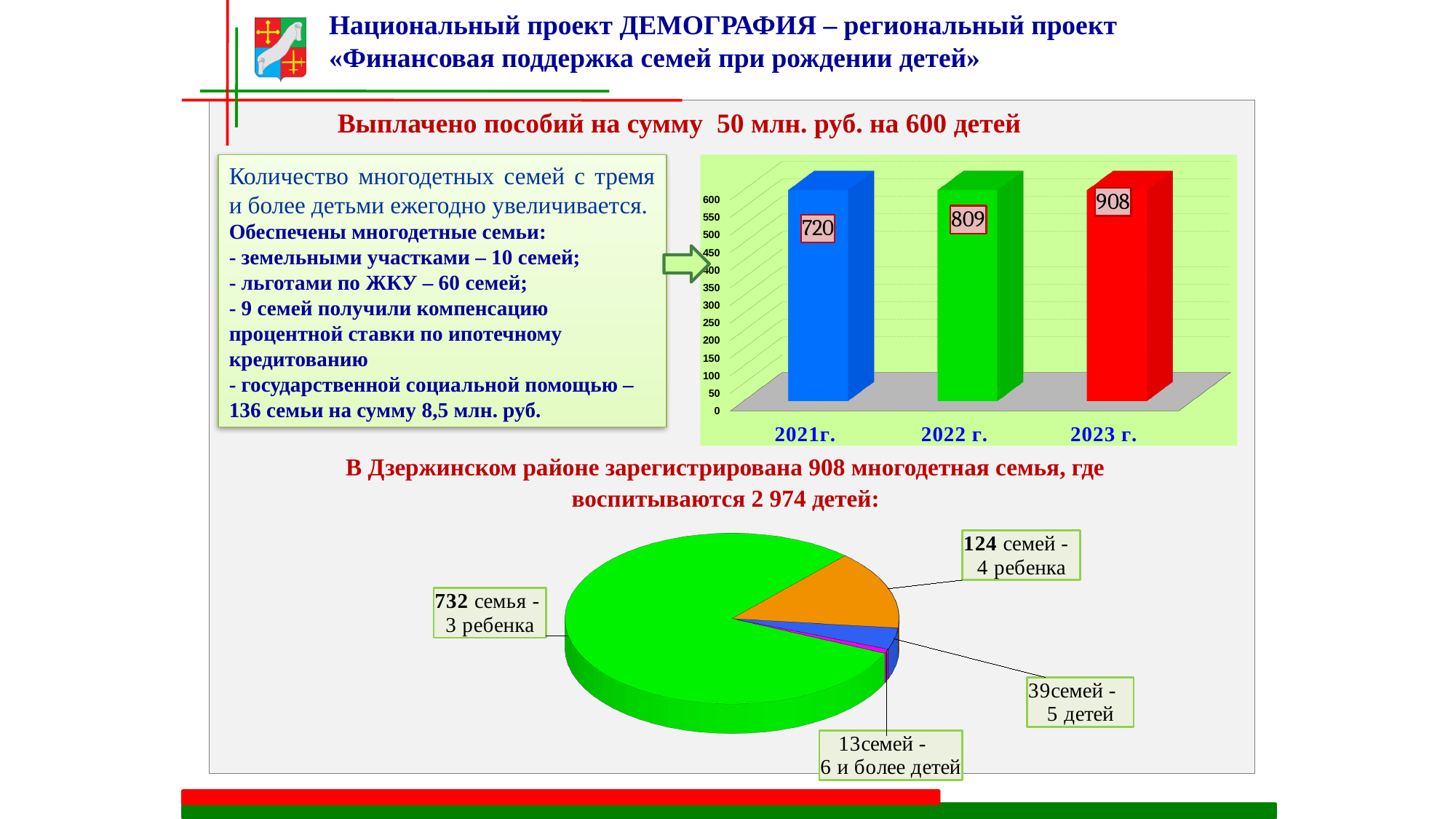
On the bar chart at the top right, what is the difference between the values for 2023 г. and 2021г.? 188 On the pie chart at the bottom, which category has the largest slice? 732 семья - 3 ребенка On the bar chart at the top right, which year has the highest value? 2023 г. On the bar chart at the top right, how many bars are plotted? 3 What kind of chart is shown at the top right of the slide? bar chart On the pie chart at the bottom, which is larger: the number of families with 5 children or with 6 and more children? 5 детей (39 семей) On the bar chart at the top right, what is the value for 2021г.? 720 On the bar chart at the top right, what is the value for 2023 г.? 908 On the pie chart at the bottom, how many families have 4 children (4 ребенка)? 124 On the pie chart at the bottom, how many slices are there? 4 On the bar chart at the top right, do the values rise or fall from 2021г. to 2023 г.? rise On the bar chart at the top right, which year has the lowest value? 2021г.